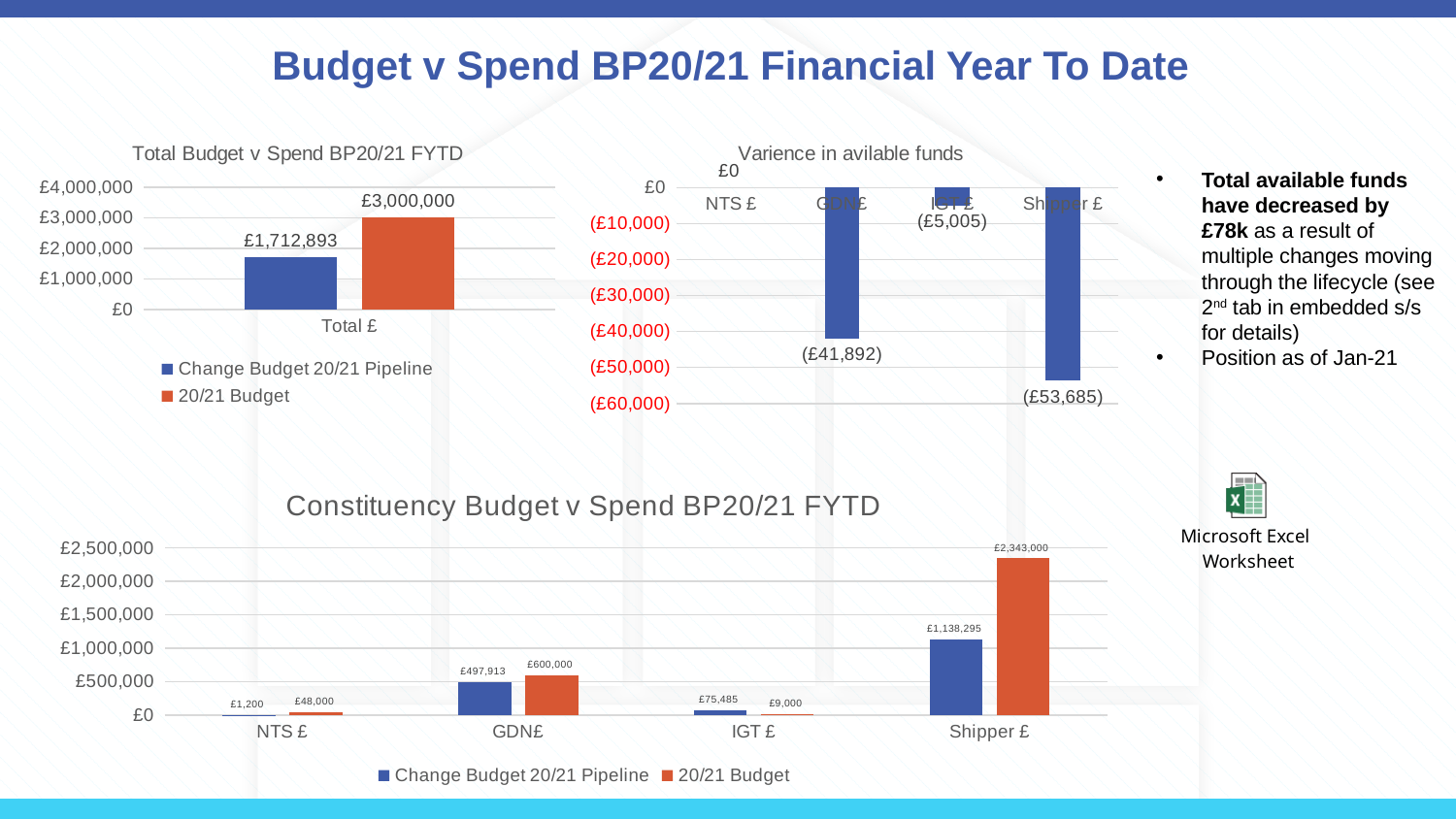
In the 'Total Budget v Spend BP20/21 FYTD' chart, what is the value of the Change Budget 20/21 Pipeline bar? £1,712,893 In the 'Total Budget v Spend BP20/21 FYTD' chart, what is the value of the 20/21 Budget bar? £3,000,000 In the 'Total Budget v Spend BP20/21 FYTD' chart, what is the difference between the 20/21 Budget and the Change Budget 20/21 Pipeline? £1,287,107 In the 'Constituency Budget v Spend BP20/21 FYTD' chart, what is the Change Budget 20/21 Pipeline value for GDN£? £497,913 How many categories are shown in the 'Varience in avilable funds' chart? 4 In the 'Constituency Budget v Spend BP20/21 FYTD' chart, which category has the highest 20/21 Budget? Shipper £ In the 'Constituency Budget v Spend BP20/21 FYTD' chart, what is the 20/21 Budget value for Shipper £? £2,343,000 In the 'Varience in avilable funds' chart, which category has the lowest (most negative) value? Shipper £ In the 'Varience in avilable funds' chart, what is the value shown for Shipper £? (£53,685) In the 'Constituency Budget v Spend BP20/21 FYTD' chart, which is larger for IGT £: the Change Budget 20/21 Pipeline or the 20/21 Budget? Change Budget 20/21 Pipeline What type of chart is the 'Constituency Budget v Spend BP20/21 FYTD' chart? Bar chart How many series does the legend of the 'Constituency Budget v Spend BP20/21 FYTD' chart list? 2